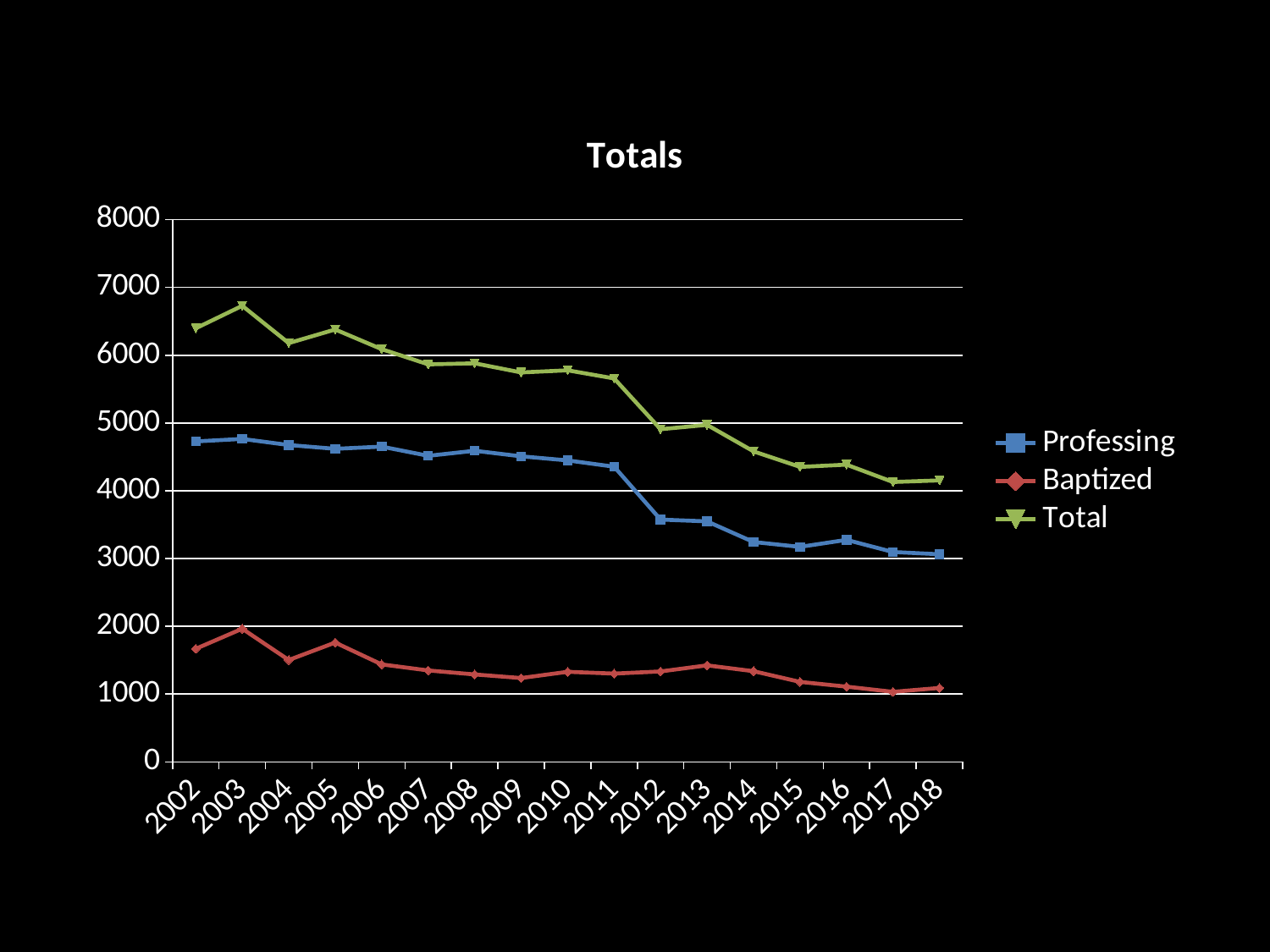
What kind of chart is shown on the slide? line chart What is the title of the chart? Totals How many years are plotted along the x axis? 17 Which is larger, the Professing value for 2011 or for 2012? 2011 In which year is the Baptized series at its highest? 2003 Is the Total value for 2014 greater or less than 5000? less In which year is the Total series at its highest? 2003 How many series does the legend list? 3 Is the Total value for 2002 greater or less than 6000? greater Is the Professing value for 2012 greater or less than 4000? less Does the Total series generally rise or fall from 2002 to 2018? fall Which series is drawn in green? Total